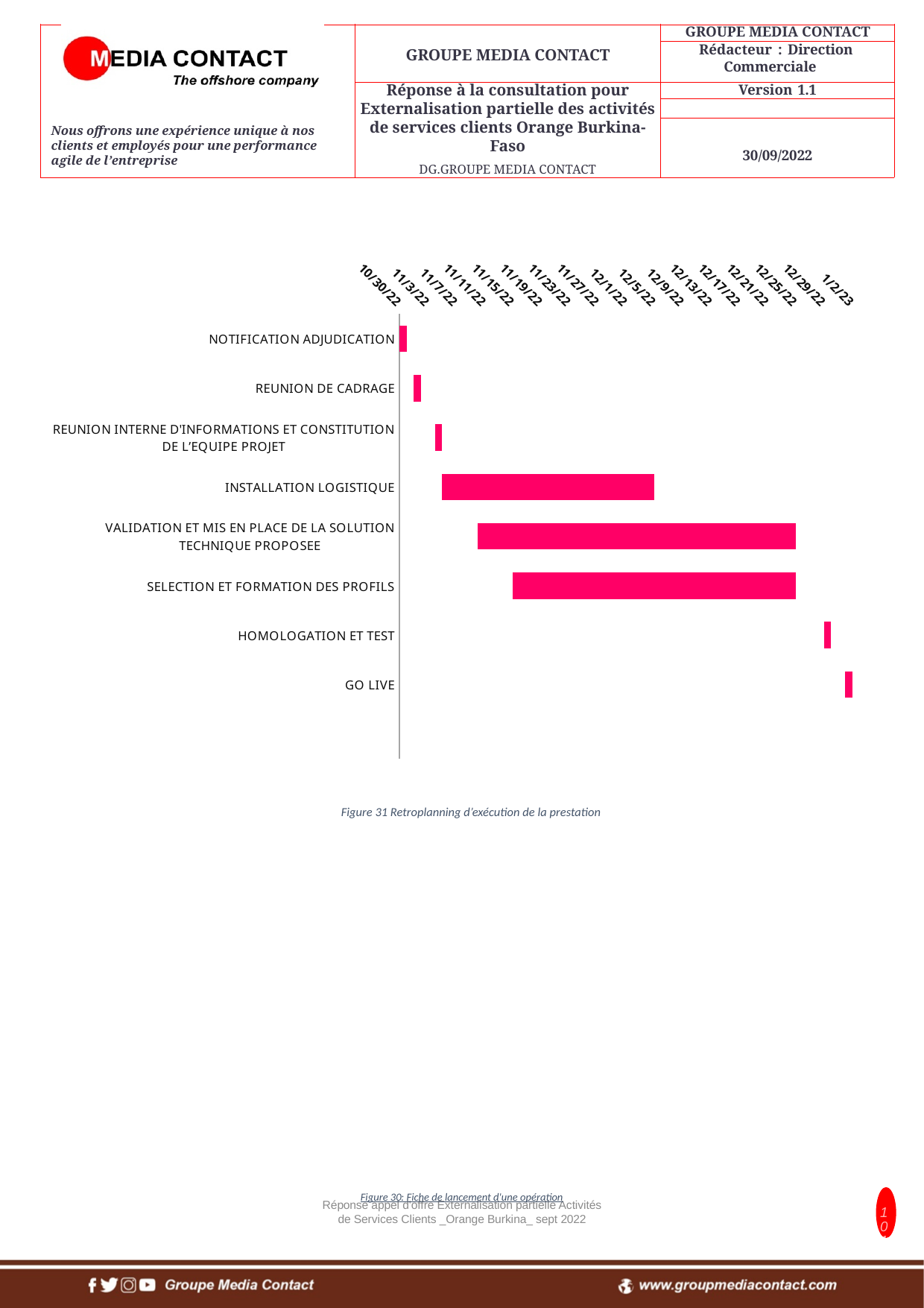
Does the INSTALLATION LOGISTIQUE bar start before or after the 11/11/22 tick on the date axis? before How many tasks (categories) are listed on the vertical axis of the chart? 8 Which bar is longer: SELECTION ET FORMATION DES PROFILS or HOMOLOGATION ET TEST? SELECTION ET FORMATION DES PROFILS Which bar is longer: INSTALLATION LOGISTIQUE or REUNION DE CADRAGE? INSTALLATION LOGISTIQUE What is the figure caption printed below the chart? Figure 31 Retroplanning d'exécution de la prestation Does the GO LIVE bar fall before or after the 12/29/22 tick on the date axis? after Does the NOTIFICATION ADJUDICATION bar fall before or after the 11/3/22 tick on the date axis? before What kind of chart is shown on the slide? Bar chart (Gantt chart) What is the first date tick shown on the horizontal axis of the chart? 10/30/22 Moving down the list of tasks from top to bottom, do the bars start earlier or later along the date axis? later Which task has the longest bar in the chart? VALIDATION ET MIS EN PLACE DE LA SOLUTION TECHNIQUE PROPOSEE